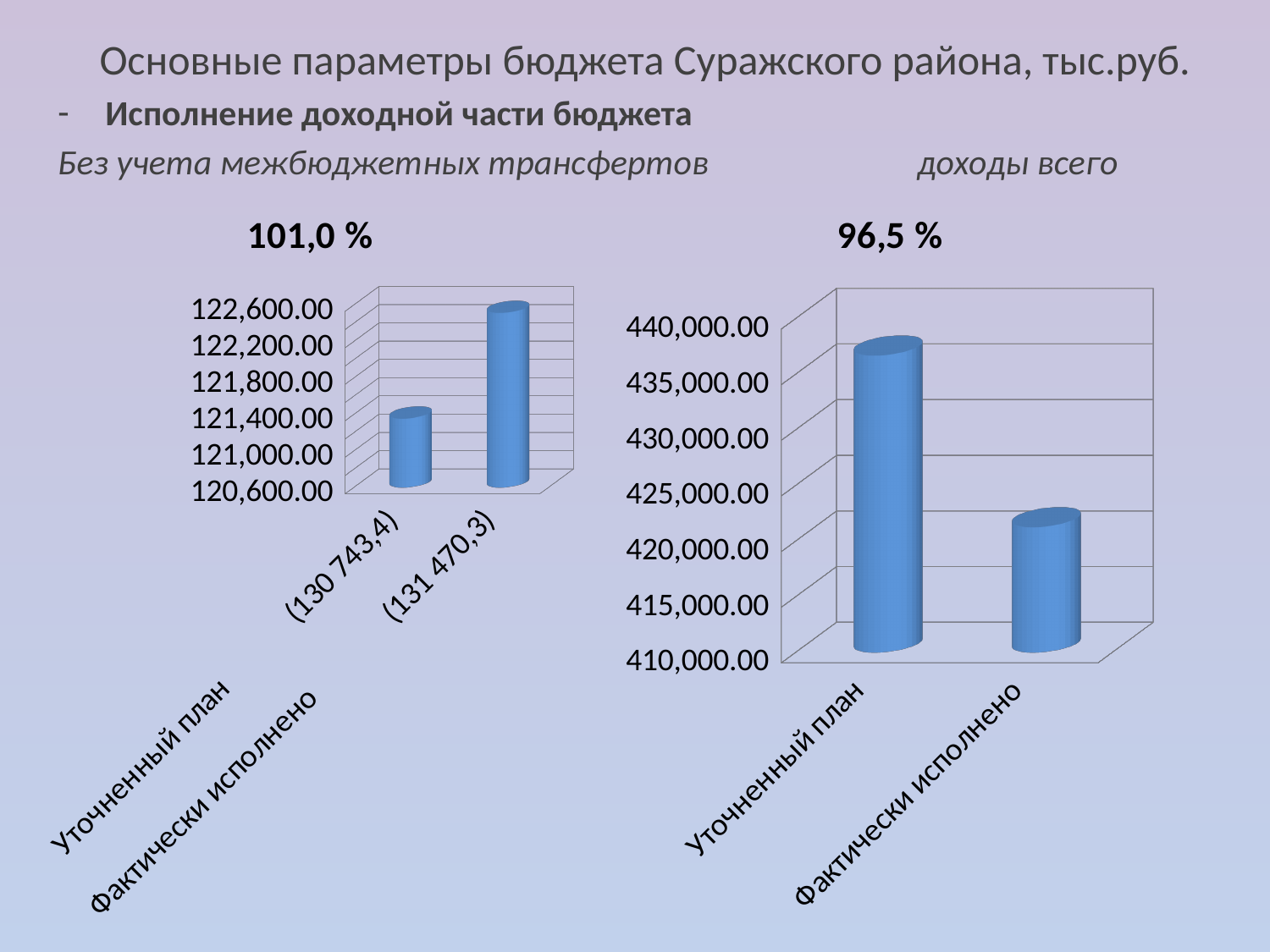
What is the highest value shown on the vertical axis of the right chart (доходы всего)? 440,000.00 In the right chart (доходы всего), is the bar for Уточненный план taller or shorter than the bar for Фактически исполнено? taller What percentage is printed above the left chart (Без учета межбюджетных трансфертов)? 101,0 % In the left chart (Без учета межбюджетных трансфертов), which category has the higher bar? Фактически исполнено In the left chart (Без учета межбюджетных трансфертов), is the value for Фактически исполнено greater or less than 122,200.00? greater What type of chart is used in the left chart (Без учета межбюджетных трансфертов)? bar chart In the left chart (Без учета межбюджетных трансфертов), is the value for Уточненный план greater or less than 121,800.00? less In the right chart (доходы всего), which category has the lower bar? Фактически исполнено In the right chart (доходы всего), is the value for Фактически исполнено greater or less than 425,000.00? less How many bars are shown in the right chart (доходы всего)? 2 What percentage is printed above the right chart (доходы всего)? 96,5 %